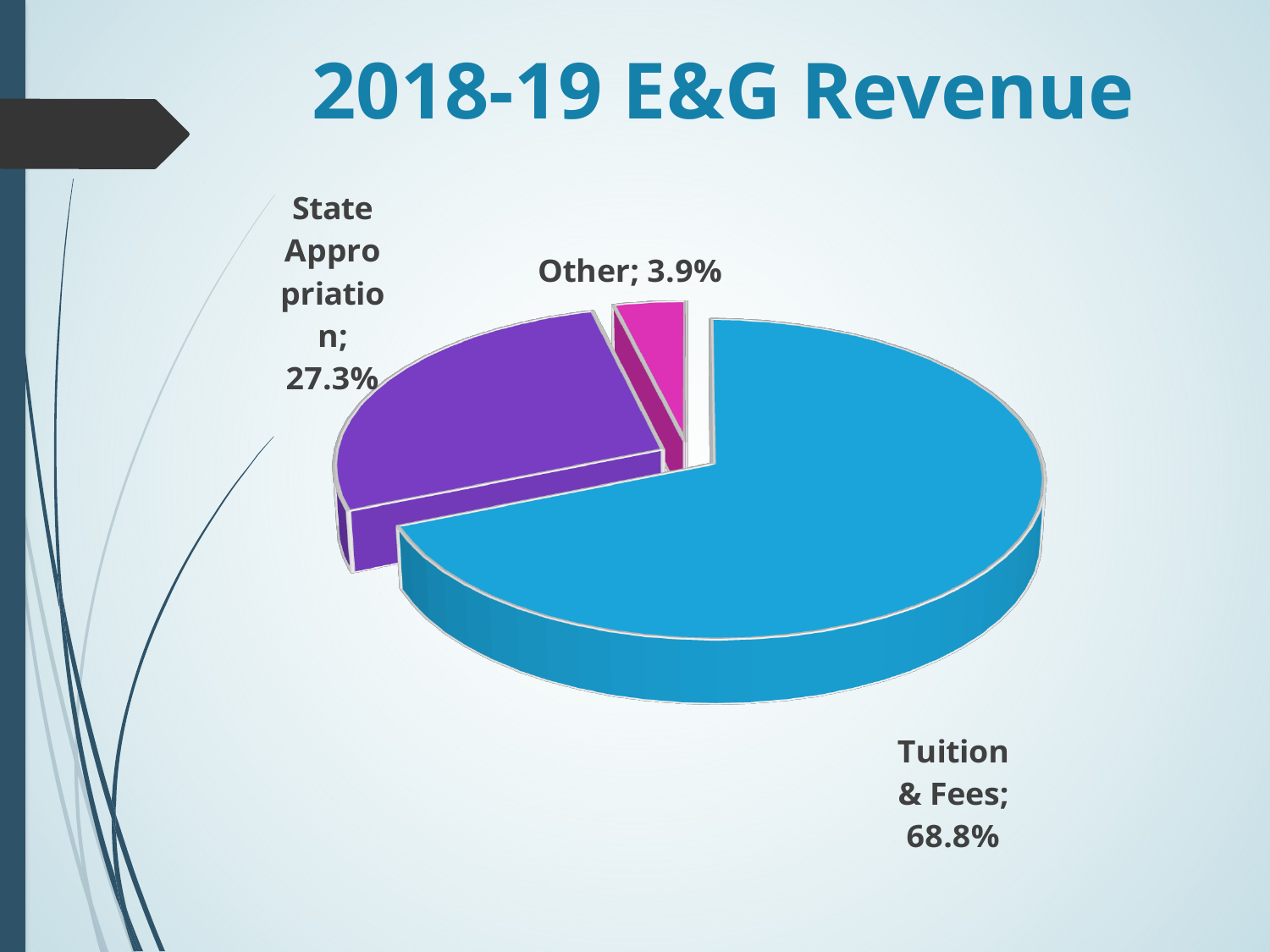
What is the title of the chart on the slide? 2018-19 E&G Revenue How many percentage points larger is the Tuition & Fees share than the State Appropriation share? 41.5 Which is larger: the share for State Appropriation or the share for Other? State Appropriation Which revenue source has the largest share of 2018-19 E&G Revenue? Tuition & Fees What share of 2018-19 E&G Revenue comes from State Appropriation? 27.3% What colour is the Tuition & Fees slice? Blue How many percentage points larger is the State Appropriation share than the Other share? 23.4 What share of 2018-19 E&G Revenue comes from Tuition & Fees? 68.8% How many slices does the 2018-19 E&G Revenue pie chart have? 3 Which revenue source has the smallest share of 2018-19 E&G Revenue? Other What share of 2018-19 E&G Revenue comes from Other? 3.9% What kind of chart is shown on the slide? Pie chart